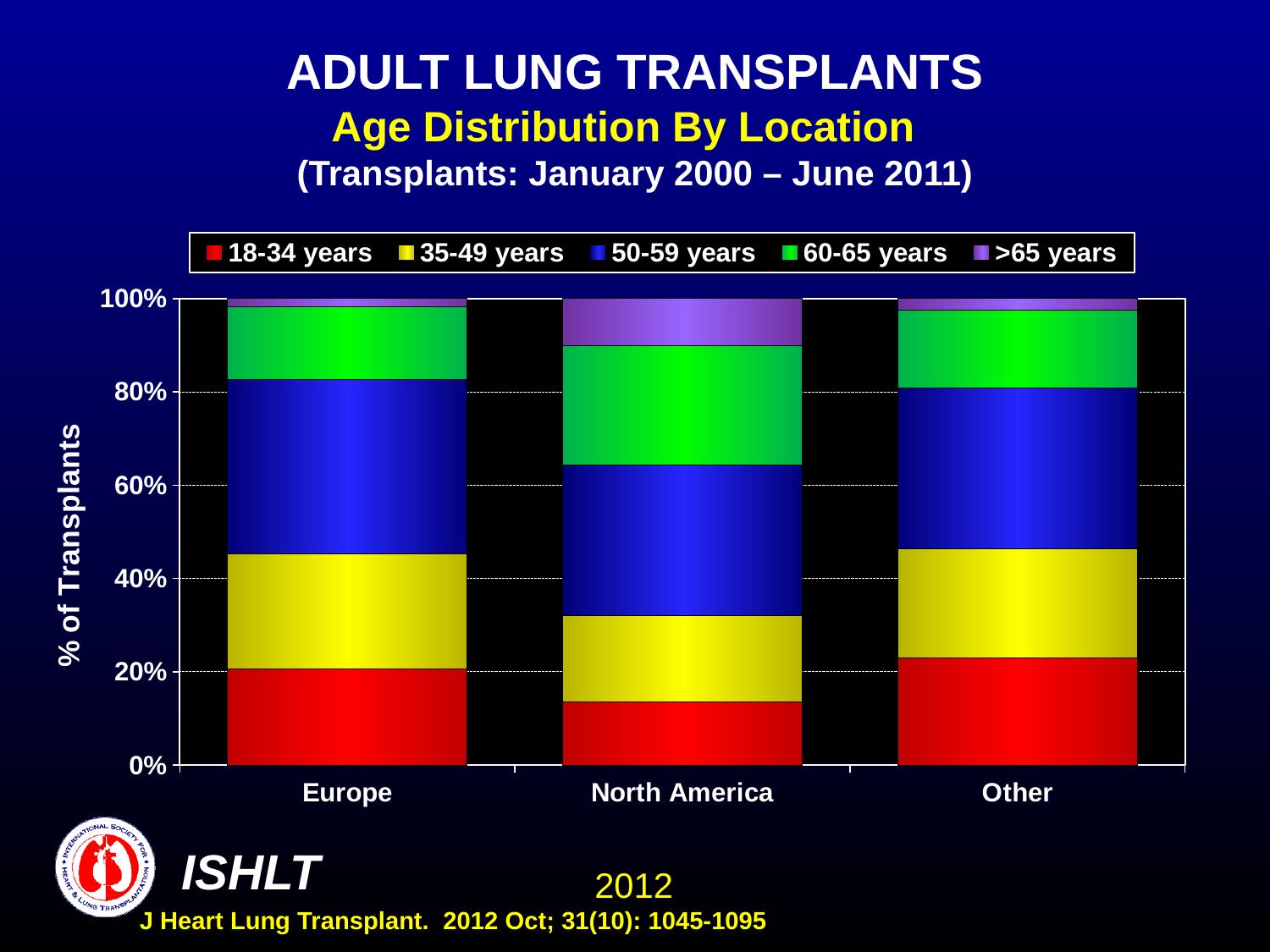
How many locations (categories) are shown on the x axis? 3 Which location has the smallest share of transplants in the 18-34 years age group? North America Which location has the largest share of transplants in the >65 years age group? North America Is the share of 18-34 years transplants in North America greater or less than 20%? less Which location has the largest share of transplants in the 60-65 years age group? North America What kind of chart is shown on the slide? Stacked bar chart How many age groups does the legend list? 5 What is the label of the y axis? % of Transplants Which is larger: the 60-65 years share in North America or the 60-65 years share in Europe? North America Is the combined share of the 18-34 and 35-49 years groups in North America greater or less than 40%? less What time period of transplants does the chart cover, according to the title? January 2000 – June 2011 What does each stacked bar total? 100%